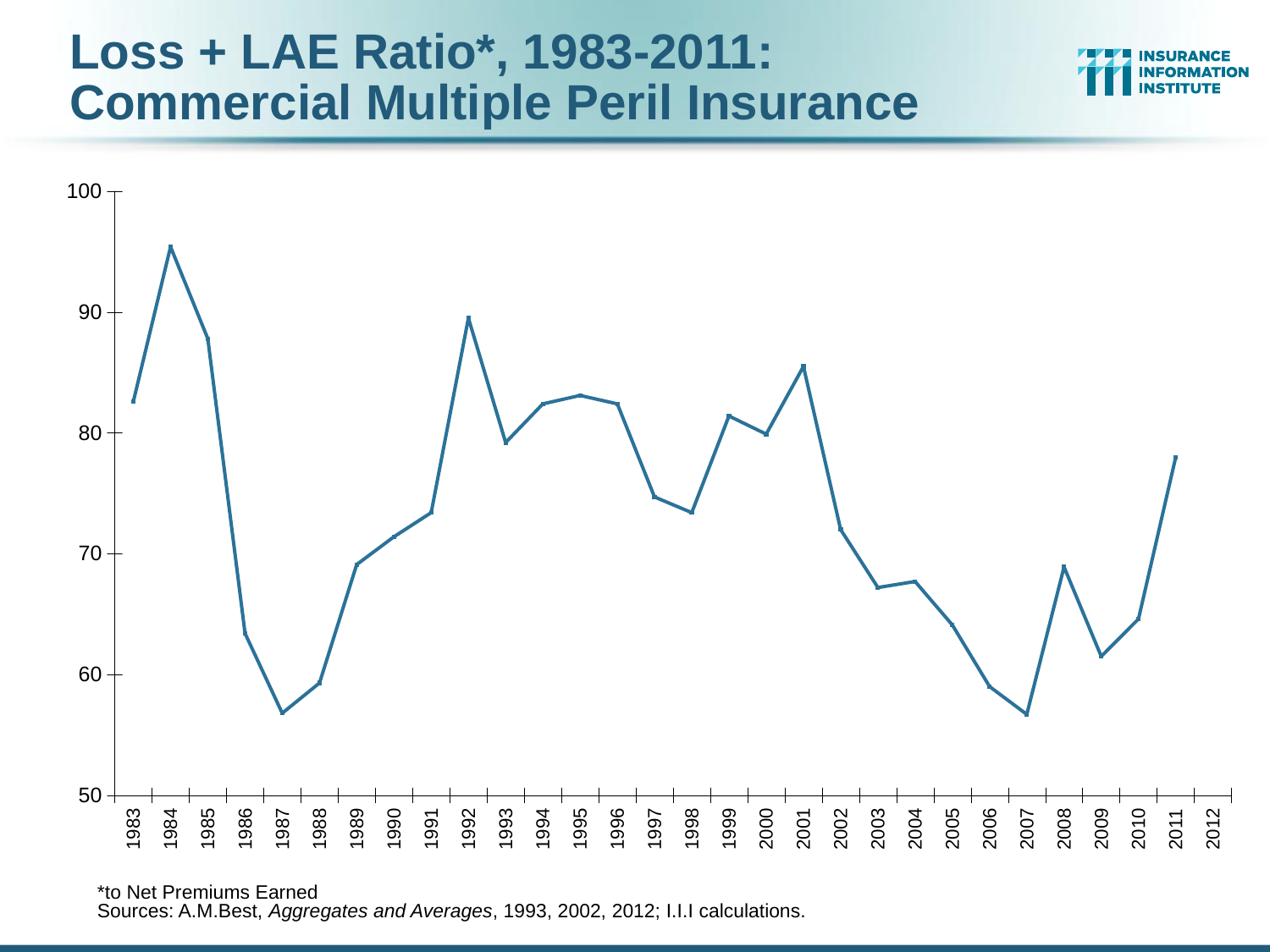
Is the value for 2003 greater or less than 70? less Which year has the larger value, 1984 or 1992? 1984 Does the line rise or fall from 1984 to 1987? Falls Is the value for 1987 greater or less than 60? less What kind of chart is shown on the slide? Line chart Which year has the larger value, 2008 or 2009? 2008 Which year has the highest Loss + LAE Ratio on the chart? 1984 Is the value for 2007 greater or less than 60? less What is the title of the chart on the slide? Loss + LAE Ratio*, 1983-2011: Commercial Multiple Peril Insurance